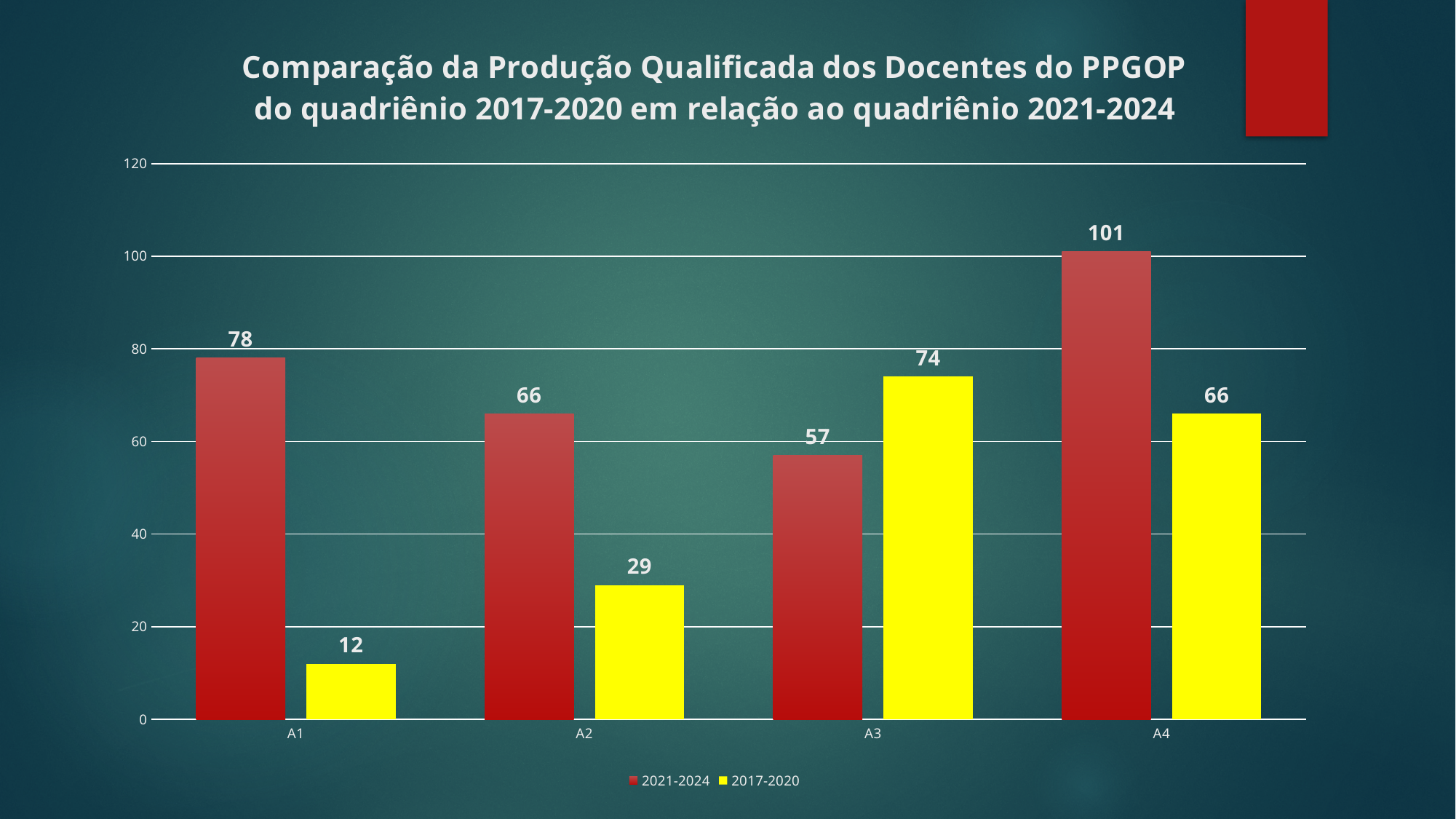
What is the value for A2 in the 2017-2020 series? 29 What kind of chart is shown on the slide? bar chart What is the value for A4 in the 2021-2024 series? 101 Which category has the lowest value in the 2017-2020 series? A1 Which colour represents the 2017-2020 series? yellow How many categories are shown on the x axis? 4 Is the value for A4 in the 2021-2024 series greater or less than 100? greater What is the difference between the 2021-2024 and 2017-2020 values for A1? 66 How many series does the legend list? 2 What is the value for A1 in the 2021-2024 series? 78 Which category has the highest value in the 2021-2024 series? A4 Which is larger for A3: the 2021-2024 value or the 2017-2020 value? 2017-2020